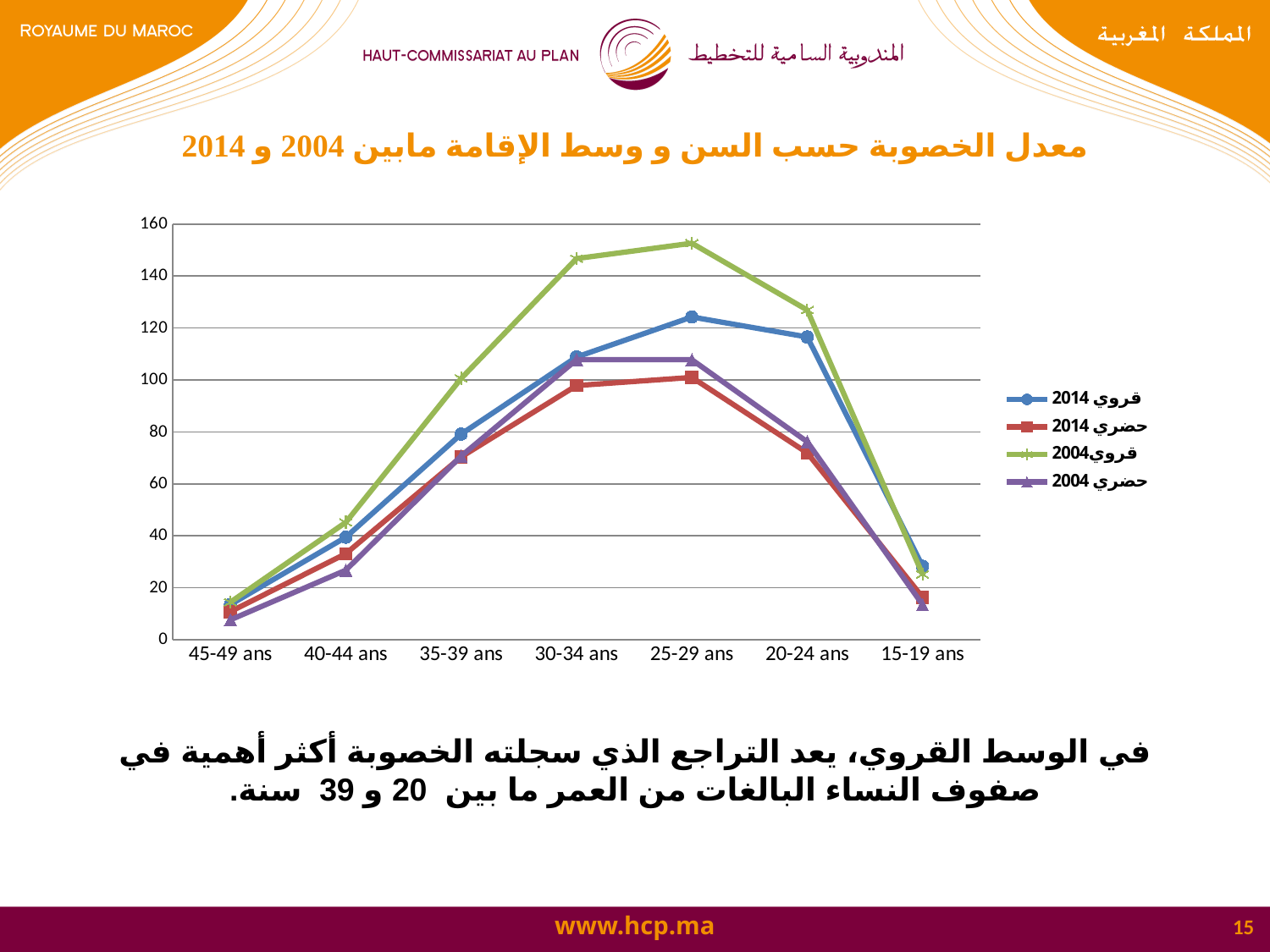
For which age group is the قروي2004 series lowest? 45-49 ans Is the value for حضري 2014 at 15-19 ans greater or less than 20? less Which series is drawn in green? قروي2004 Do the values for all series rise or fall from 25-29 ans to 15-19 ans? fall Is the value for حضري 2004 at 45-49 ans greater or less than 20? less How many series does the legend list? 4 How many age groups are shown on the x axis? 7 Is the value for قروي 2014 at 35-39 ans greater or less than 100? less At 30-34 ans, which is larger: قروي 2014 or حضري 2014? قروي 2014 For which age group is the قروي2004 series highest? 25-29 ans What kind of chart is shown on the slide? line chart